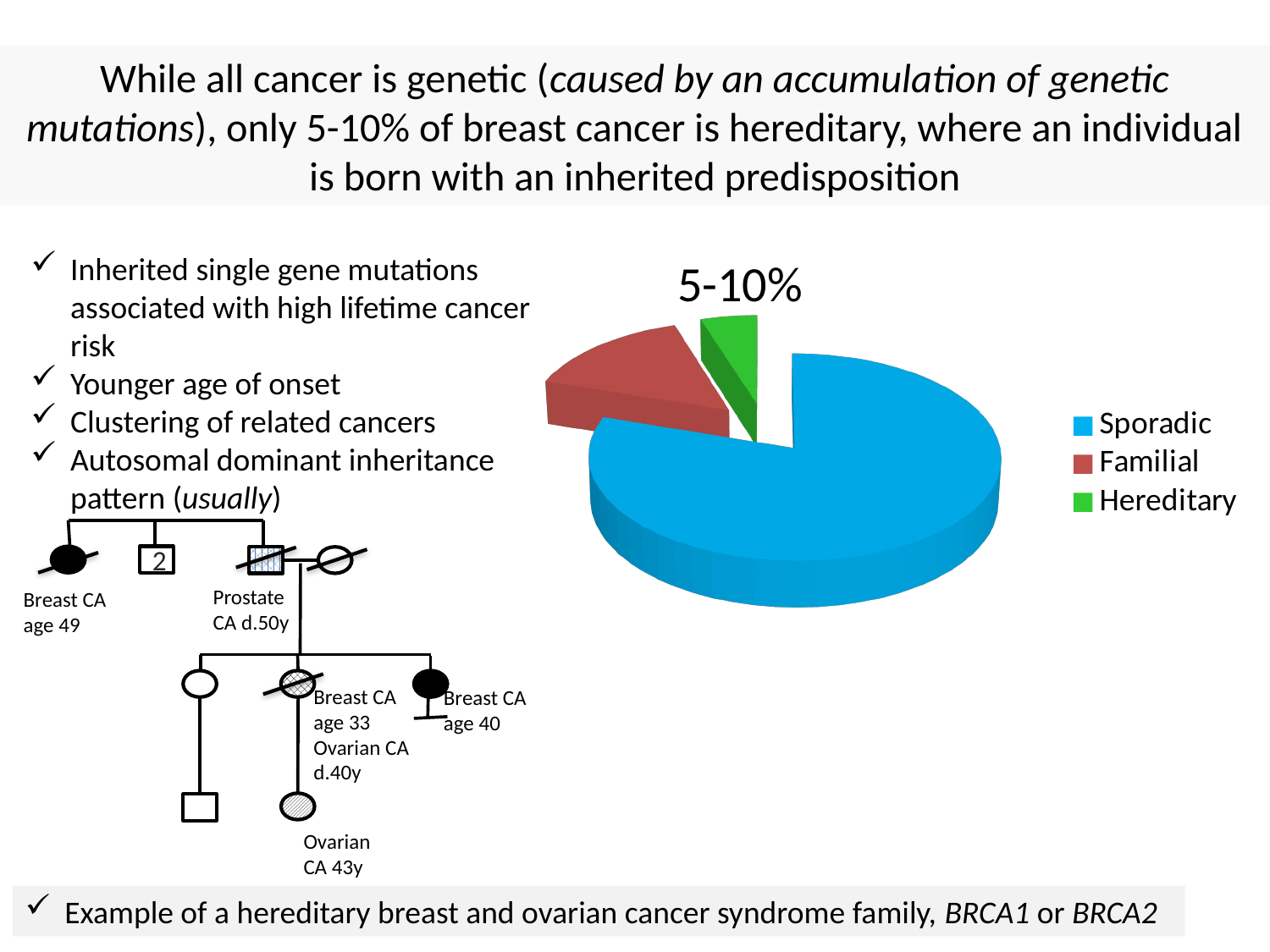
Which slice is larger in the pie chart, Familial or Hereditary? Familial What percentage label is printed above the Hereditary slice of the pie chart? 5-10% Which category has the smallest slice in the pie chart? Hereditary What kind of chart is shown on the slide? pie chart How many entries does the pie chart's legend list? 3 How many slices does the pie chart have? 3 Which legend entry is shown in green in the pie chart? Hereditary Which category has the largest slice in the pie chart? Sporadic Which slice is larger in the pie chart, Sporadic or Familial? Sporadic What colour is the Sporadic slice in the pie chart? blue